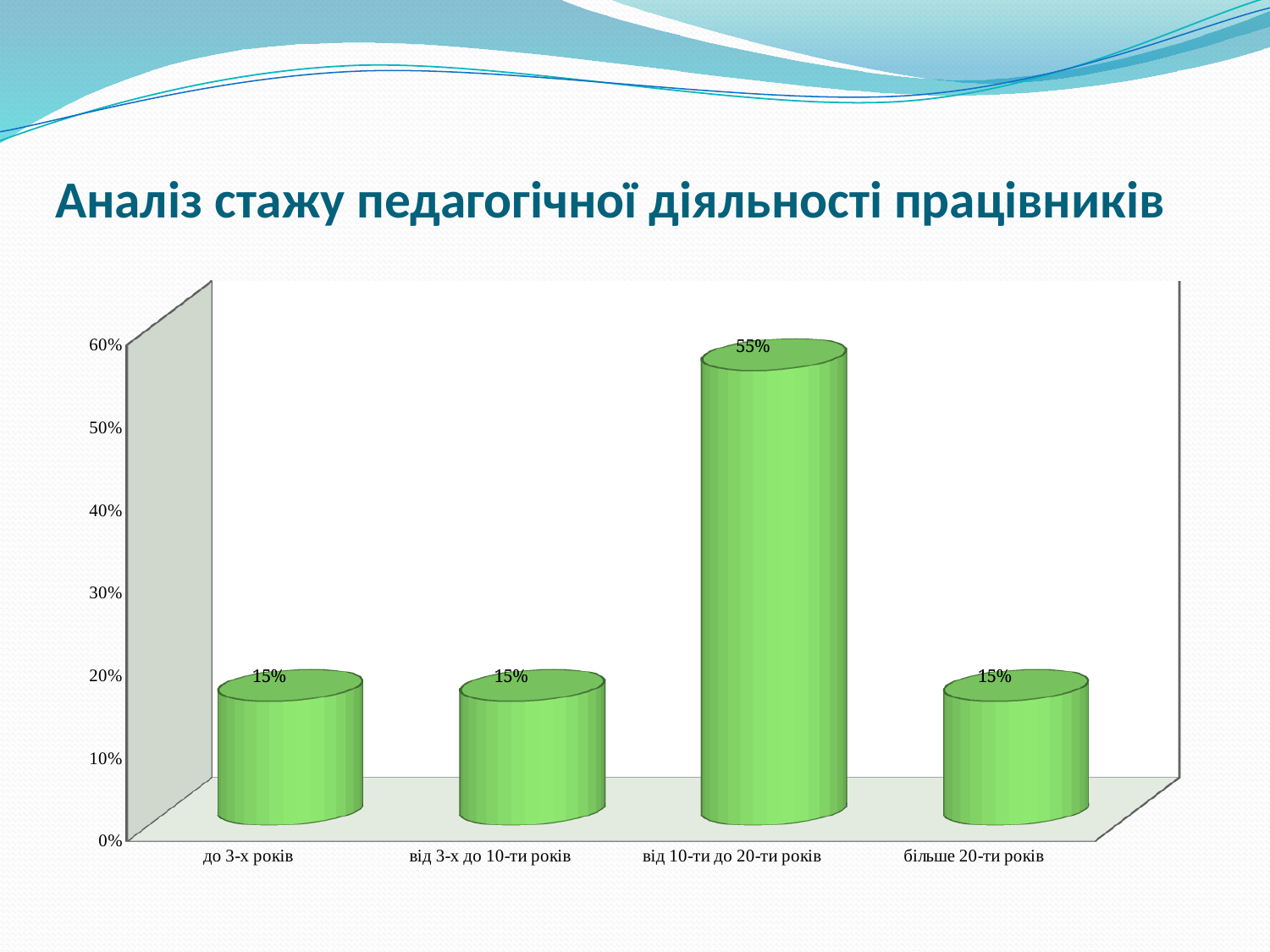
How many categories are shown on the x axis? 4 What is the title of the slide? Аналіз стажу педагогічної діяльності працівників What is the value for the category 'більше 20-ти років'? 15% What is the value for the category 'до 3-х років'? 15% Is the value for 'від 10-ти до 20-ти років' greater or less than 50%? greater What is the difference between the values for 'від 10-ти до 20-ти років' and 'від 3-х до 10-ти років'? 40% Which is larger: the value for 'від 10-ти до 20-ти років' or the value for 'більше 20-ти років'? від 10-ти до 20-ти років What is the value for the category 'від 10-ти до 20-ти років'? 55% What kind of chart is shown on the slide? bar chart Which category has the highest value? від 10-ти до 20-ти років Is the value for 'до 3-х років' greater or less than 20%? less What is the highest value shown on the vertical axis? 60%